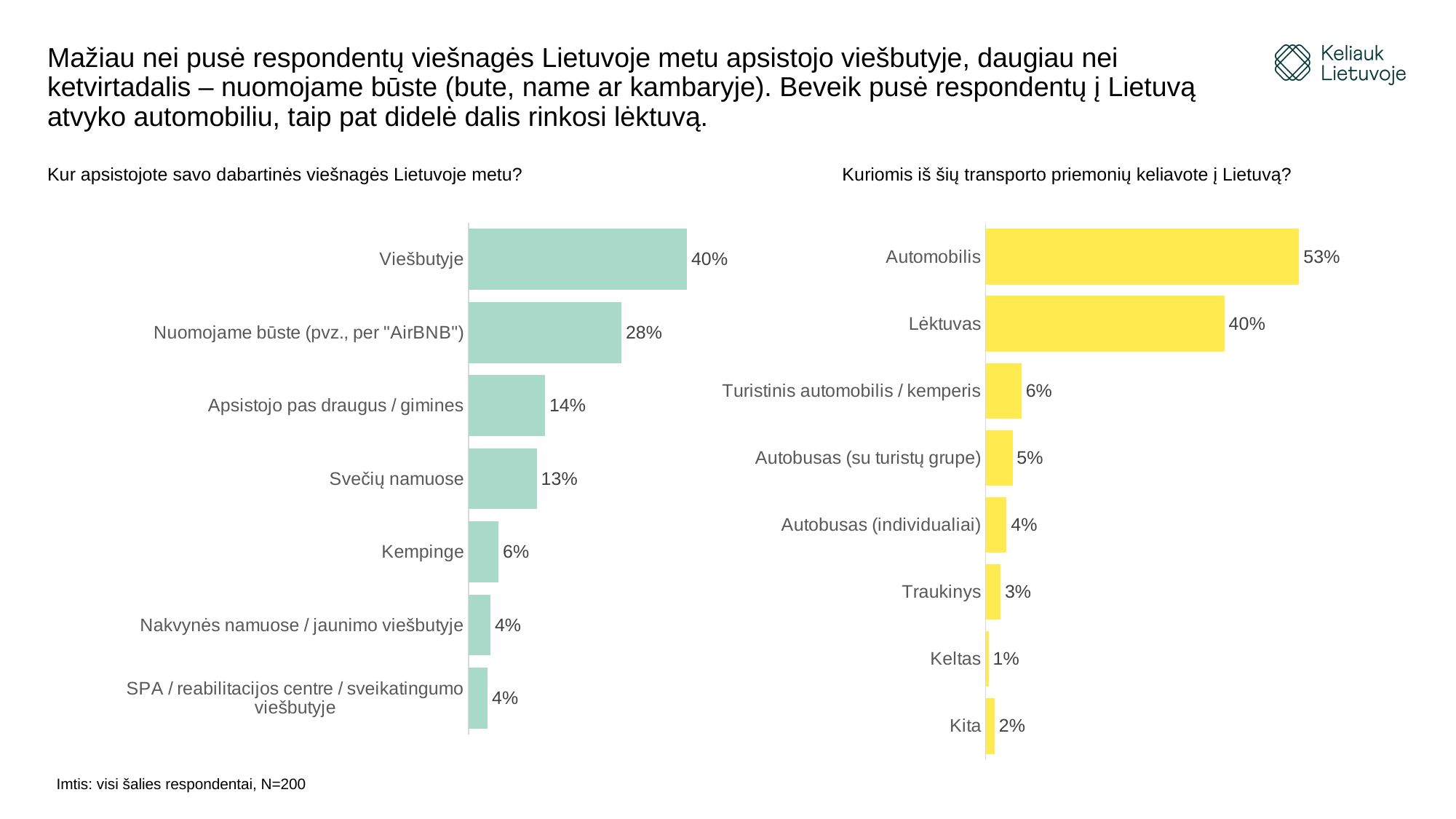
In the right chart (Kuriomis iš šių transporto priemonių keliavote į Lietuvą?), which category has the highest value? Automobilis In the left chart (Kur apsistojote savo dabartinės viešnagės Lietuvoje metu?), what is the difference between Viešbutyje and Nuomojame būste (pvz., per "AirBNB")? 12% How many categories are shown in the left chart (Kur apsistojote savo dabartinės viešnagės Lietuvoje metu?)? 7 In the left chart (Kur apsistojote savo dabartinės viešnagės Lietuvoje metu?), what is the value for Svečių namuose? 13% In the left chart (Kur apsistojote savo dabartinės viešnagės Lietuvoje metu?), what is the value for Viešbutyje? 40% In the right chart (Kuriomis iš šių transporto priemonių keliavote į Lietuvą?), which is larger: Turistinis automobilis / kemperis or Traukinys? Turistinis automobilis / kemperis What type of chart is the right chart (Kuriomis iš šių transporto priemonių keliavote į Lietuvą?)? Bar chart In the right chart (Kuriomis iš šių transporto priemonių keliavote į Lietuvą?), what is the difference between Automobilis and Lėktuvas? 13% In the right chart (Kuriomis iš šių transporto priemonių keliavote į Lietuvą?), which category has the lowest value? Keltas In the left chart (Kur apsistojote savo dabartinės viešnagės Lietuvoje metu?), which category has the highest value? Viešbutyje How many categories are shown in the right chart (Kuriomis iš šių transporto priemonių keliavote į Lietuvą?)? 8 In the right chart (Kuriomis iš šių transporto priemonių keliavote į Lietuvą?), what is the value for Lėktuvas? 40%